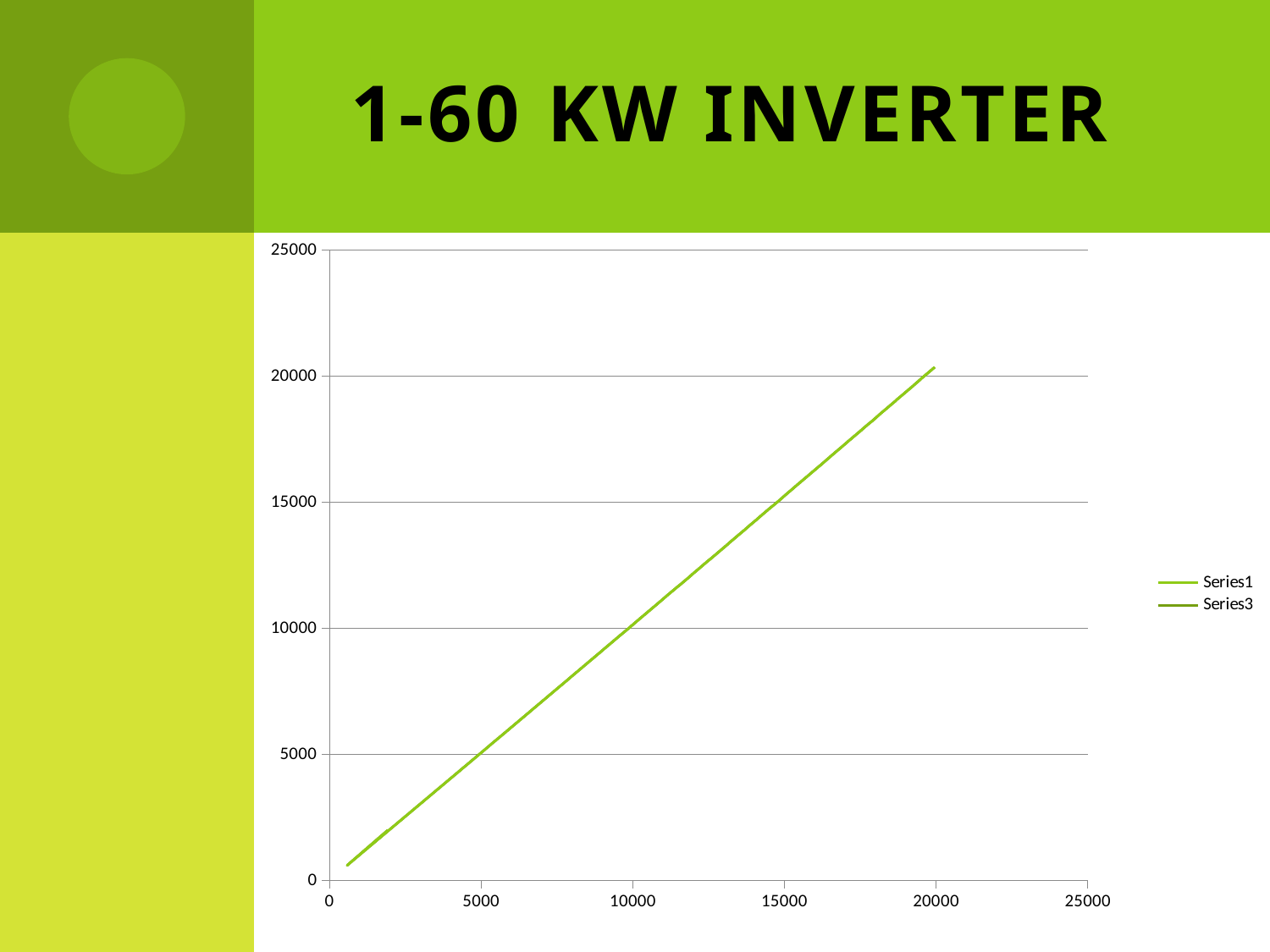
Is the plotted value at x = 15000 greater or less than 10000? greater How many series does the chart legend list? 2 What is the highest value shown on the chart's vertical axis? 25000 What are the names of the series listed in the chart legend? Series1 and Series3 Is the plotted value at x = 5000 greater or less than 0? greater Is the plotted value at x = 20000 greater or less than 25000? less Do the plotted values rise or fall as the x axis increases? rise What kind of chart is shown on the slide? line chart